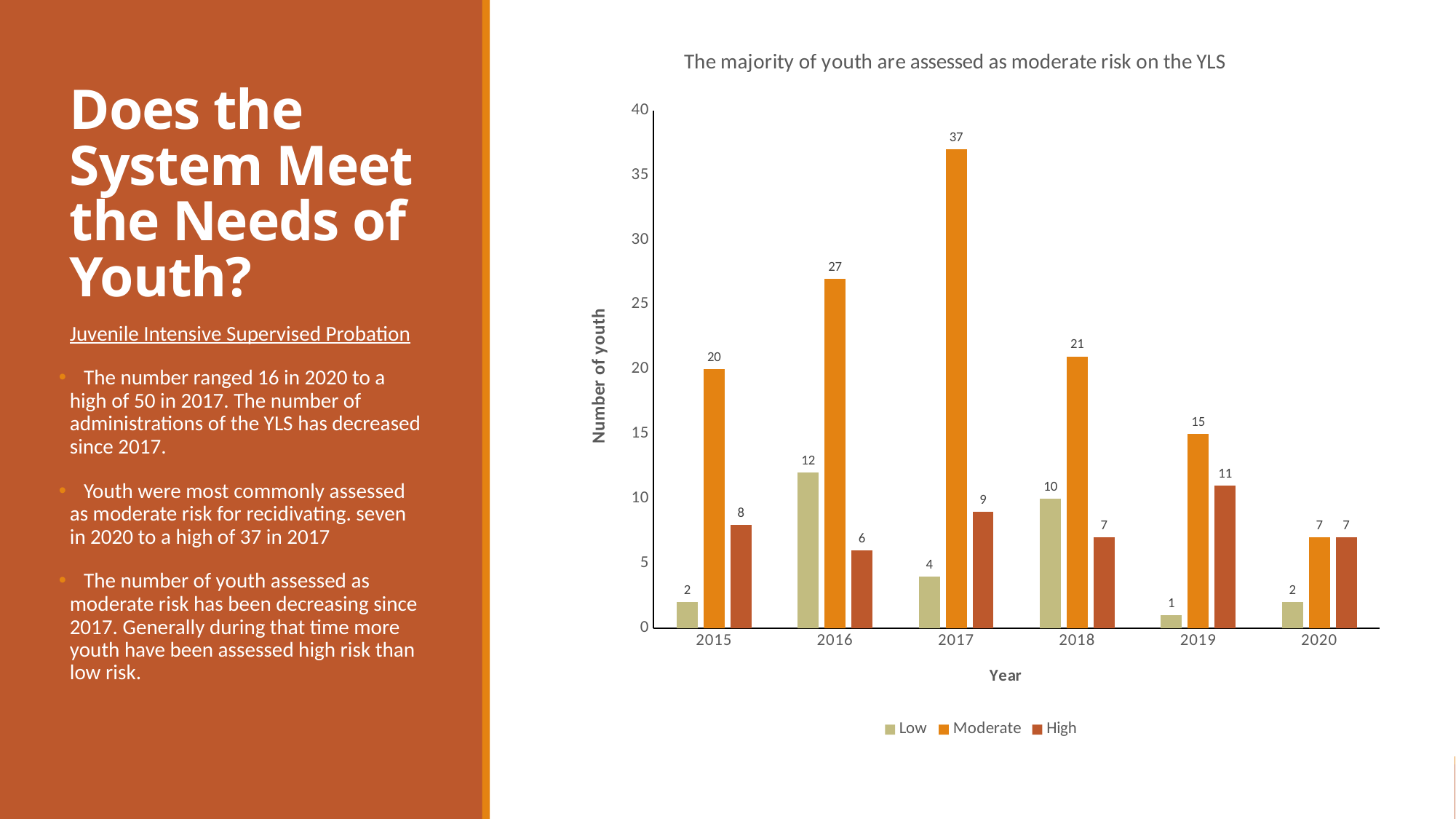
In which year is the Low risk value lowest? 2019 In which year is the Moderate risk value highest? 2017 Which is larger in 2020, the Low value or the Moderate value? Moderate How many years are shown on the x axis? 6 What is the title of the chart? The majority of youth are assessed as moderate risk on the YLS What is the number of youth assessed as High risk in 2019? 11 What is the number of youth assessed as Low risk in 2016? 12 Is the Moderate value for 2016 greater or less than 25? greater What is the number of youth assessed as Moderate risk in 2017? 37 How many series does the legend list? 3 What is the difference between the Moderate and High values in 2018? 14 What kind of chart is shown on the slide? Bar chart